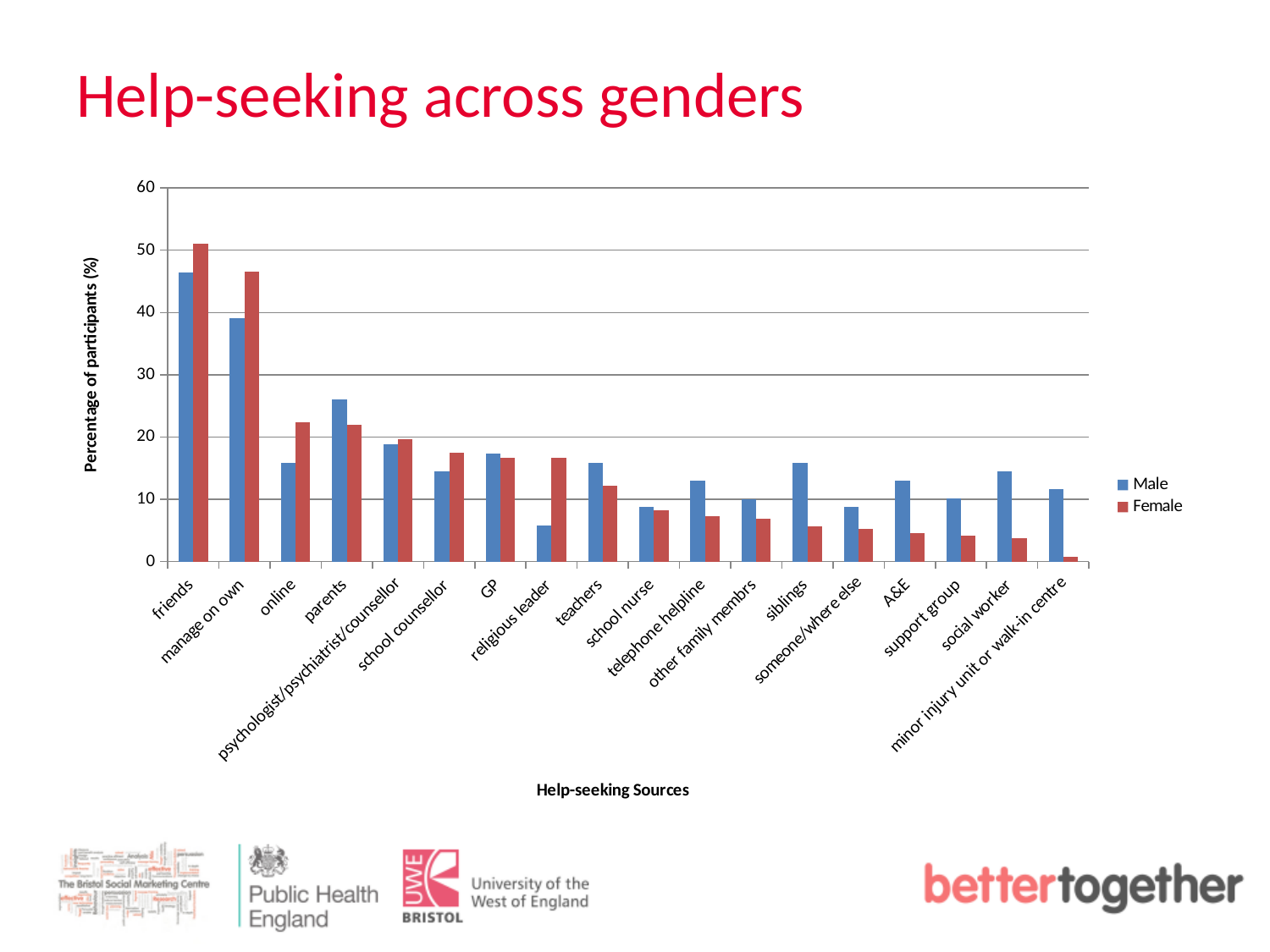
Is the Female value for siblings greater or less than 10? less For siblings, which is larger, the Male value or the Female value? Male What is the label of the y axis? Percentage of participants (%) Which help-seeking source has the lowest Female value? minor injury unit or walk-in centre For religious leader, which is larger, the Male value or the Female value? Female How many series does the legend list? 2 What kind of chart is shown on the slide? bar chart Which help-seeking source has the highest Female value? friends Which help-seeking source has the lowest Male value? religious leader How many help-seeking source categories are shown on the x axis? 18 Is the Male value for parents greater or less than 20? greater Which help-seeking source has the highest Male value? friends